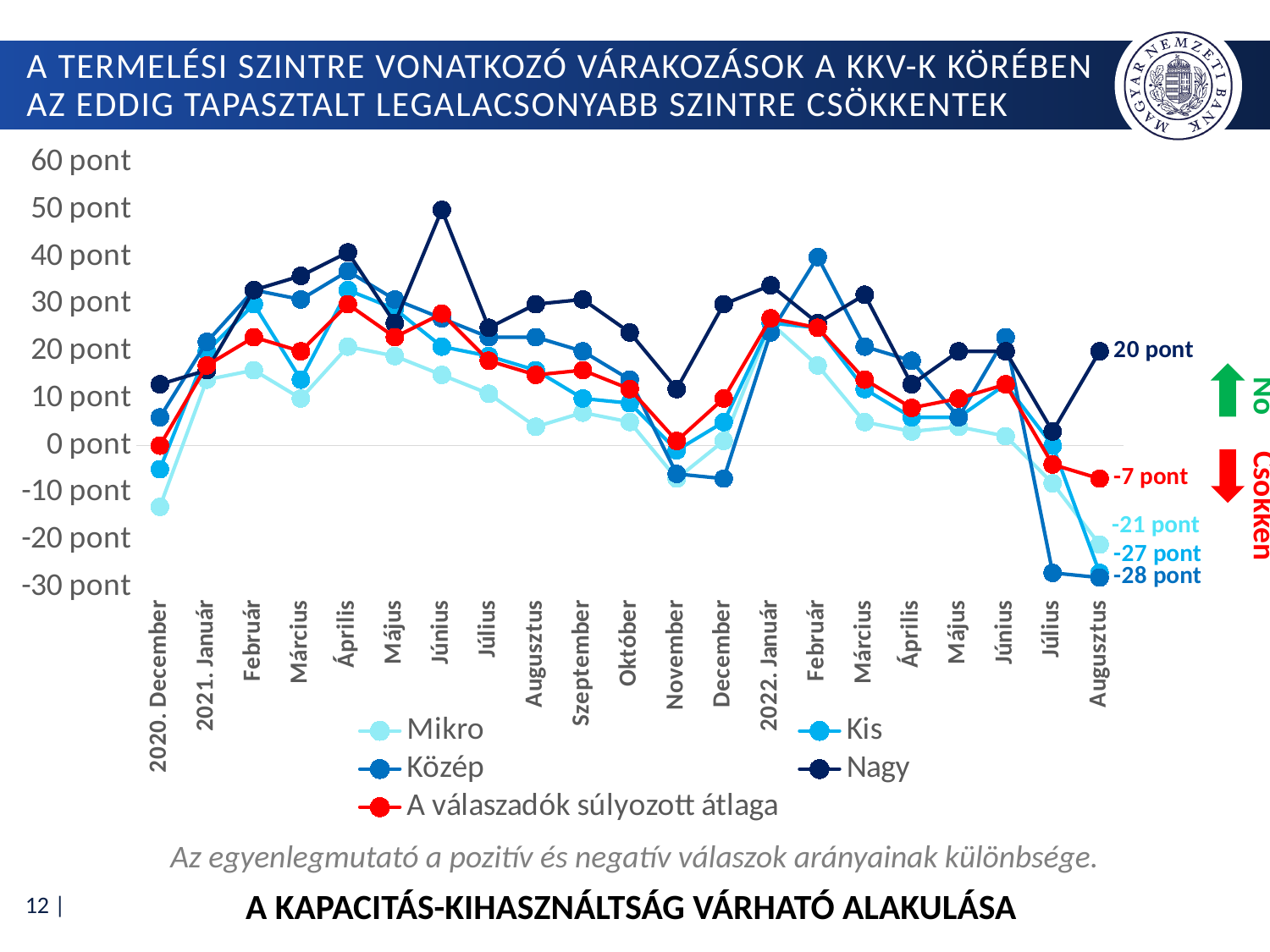
What is the value for the Mikro series in Augusztus (2022)? -21 pont Which series has the highest value in Augusztus (2022)? Nagy Which series is drawn in red? A válaszadók súlyozott átlaga What kind of chart is shown on the slide? line chart What is the difference between the Nagy value and the weighted average value in Augusztus (2022)? 27 pont Which series has the lowest value in Augusztus (2022)? Közép What is the value for 'A válaszadók súlyozott átlaga' in Augusztus (2022)? -7 pont How many series does the legend list? 5 How many months (points) are shown along the x axis? 21 What is the value for the Nagy series in Augusztus (2022)? 20 pont Is the value for the Nagy series in Június 2021 greater or less than 40 pont? greater What is the value for the Közép series in Augusztus (2022)? -28 pont